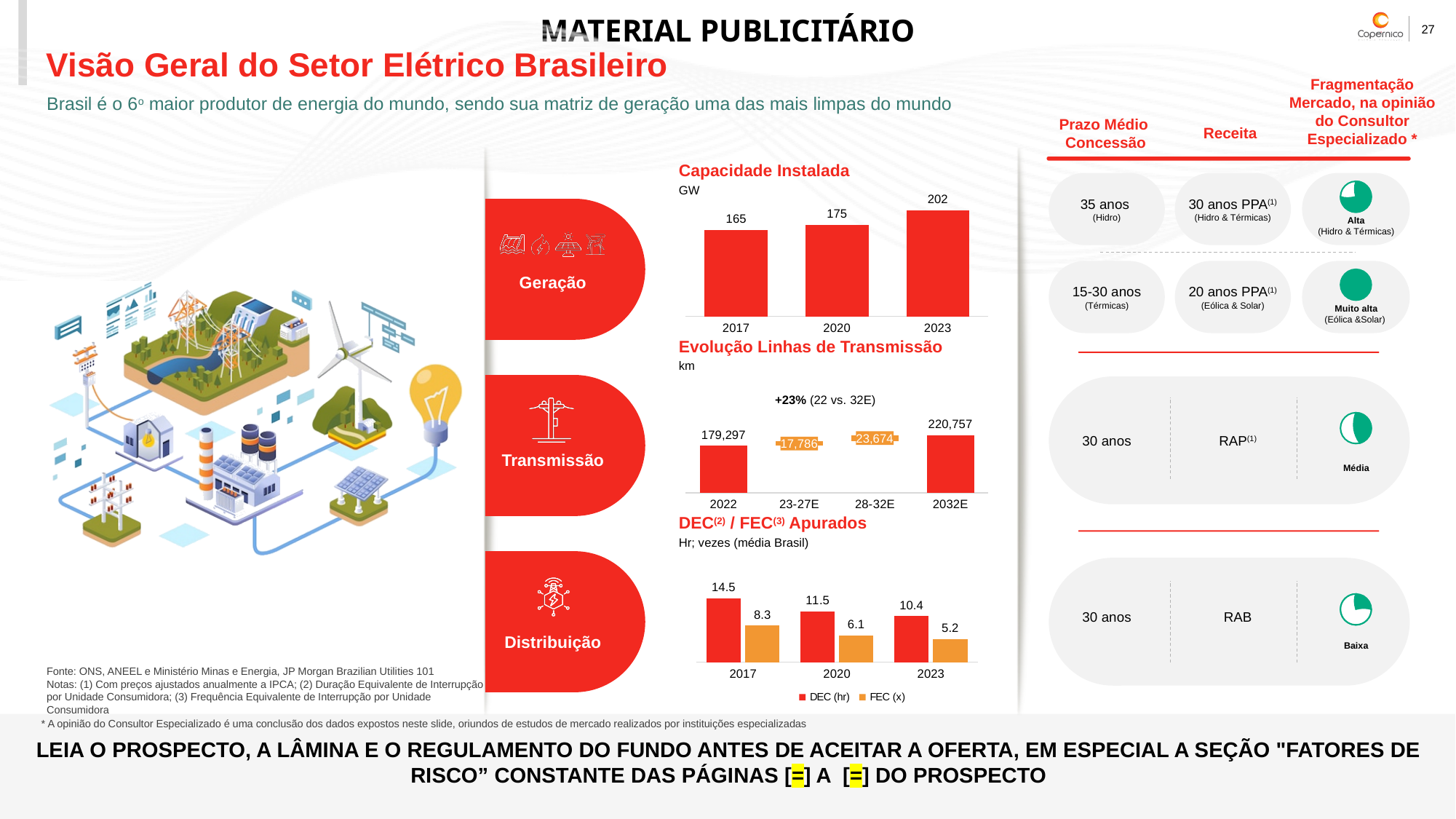
In the 'DEC / FEC Apurados' chart, what is the DEC (hr) value for 2017? 14.5 In the 'Evolução Linhas de Transmissão' chart, what is the value for 2032E? 220,757 In the 'Capacidade Instalada' chart, which year has the lowest value? 2017 In the 'DEC / FEC Apurados' chart, how many series does the legend list? 2 In the 'Capacidade Instalada' chart, do the values rise or fall from 2017 to 2023? rise In the 'Evolução Linhas de Transmissão' chart, how many categories are shown on the x axis? 4 In the 'Evolução Linhas de Transmissão' chart, what is the increment shown for 28-32E? 23,674 In the 'Capacidade Instalada' chart, what is the value for 2023? 202 In the 'Evolução Linhas de Transmissão' chart, what is the value for 2022? 179,297 In the 'DEC / FEC Apurados' chart, what is the FEC (x) value for 2023? 5.2 In the 'DEC / FEC Apurados' chart, which is larger in 2020: DEC (hr) or FEC (x)? DEC (hr) In the 'Capacidade Instalada' chart, what is the difference between the 2023 and 2017 values? 37